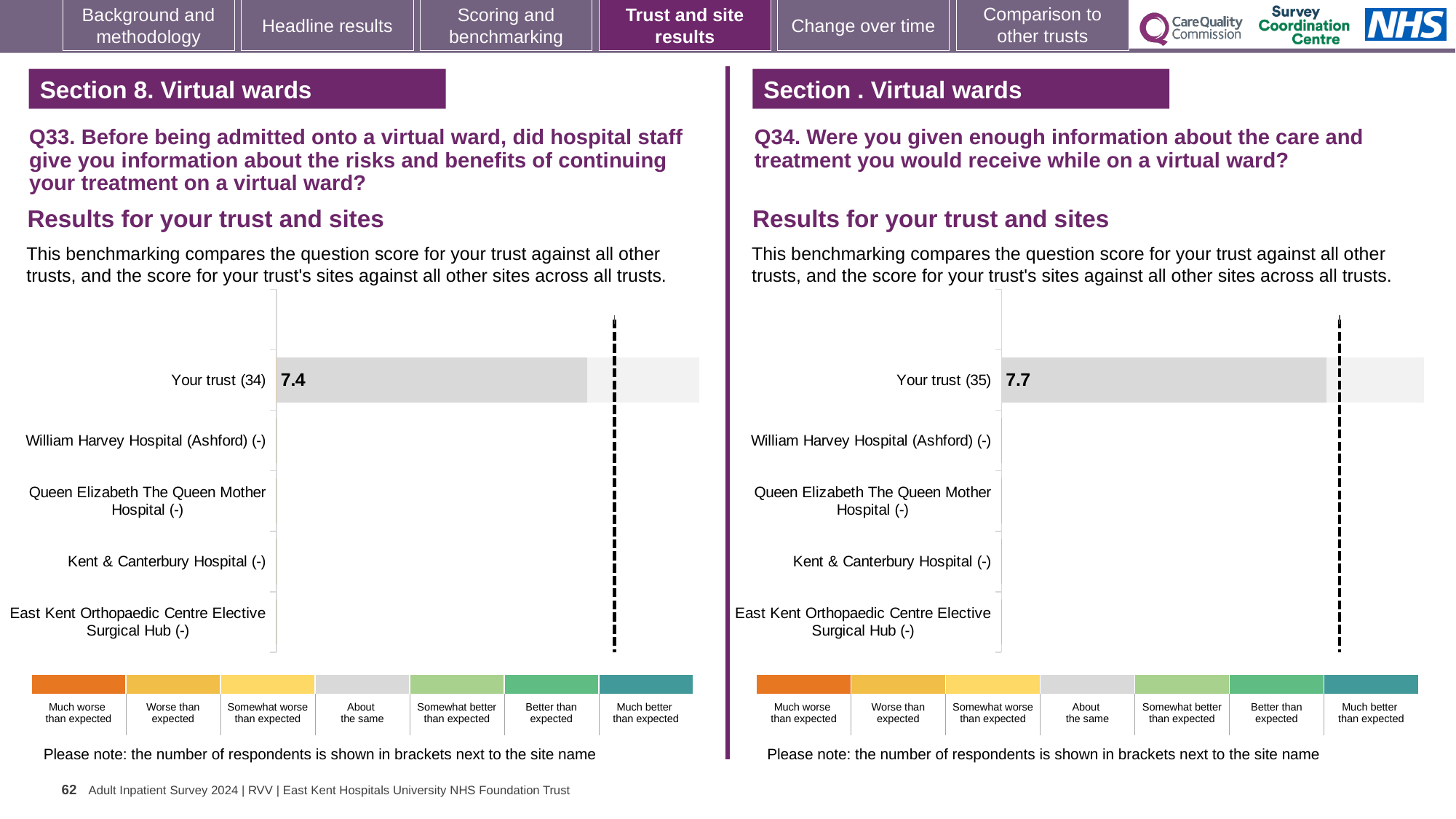
What is the difference between the Your trust score in the Q34 chart (7.7) and the Your trust score in the Q33 chart (7.4)? 0.3 In the Q33 chart on the left, which category has the highest score shown? Your trust (34) In the Q34 chart on the right, what is the score for Your trust? 7.7 What kind of chart is used in the Q33 chart on the left? Bar chart In the Q33 chart on the left, what is the score for Your trust? 7.4 In the Q33 chart on the left, how many respondents are shown in brackets next to Your trust? 34 How many categories (rows) are listed on the y axis of the Q34 chart on the right? 5 How many colour bands does the legend below the Q34 chart on the right list? 7 Comparing the Your trust scores, which is larger: the Q33 chart on the left or the Q34 chart on the right? Q34 chart on the right How many categories (rows) are listed on the y axis of the Q33 chart on the left? 5 In the Q34 chart on the right, how many respondents are shown in brackets next to Your trust? 35 In the Q33 chart on the left, what is the label of the last category at the bottom of the y axis? East Kent Orthopaedic Centre Elective Surgical Hub (-)